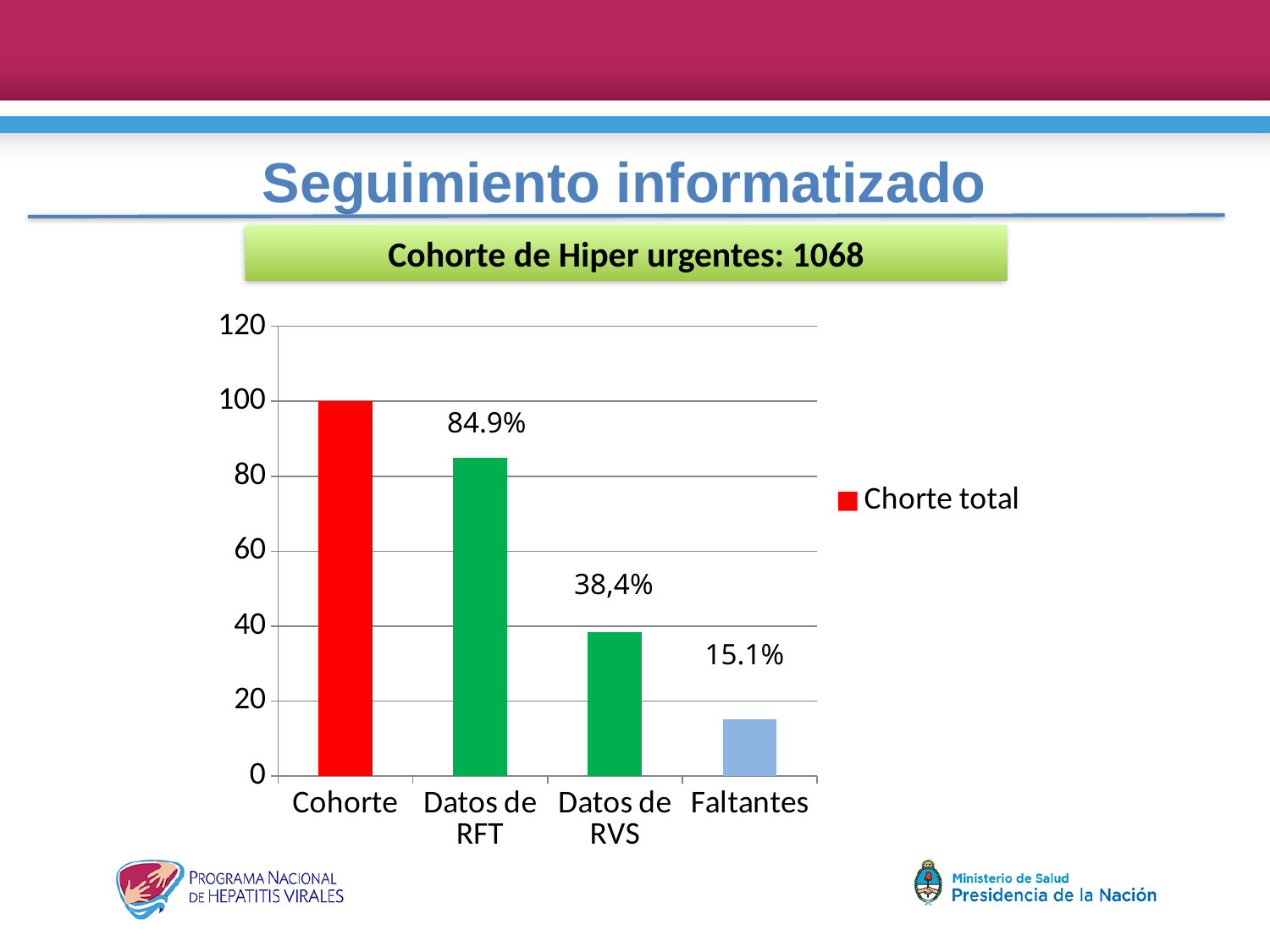
What value is labelled on the bar for Datos de RVS? 38,4% What is the difference between the labelled values for Datos de RFT and Faltantes? 69.8% How many categories are shown on the x axis? 4 Is the value for Datos de RVS greater or less than 40? less Which is larger, the value for Datos de RFT or the value for Datos de RVS? Datos de RFT What value is labelled on the bar for Faltantes? 15.1% What value does the Cohorte bar reach on the vertical axis? 100 What kind of chart is shown on the slide? bar chart Which category has the highest bar? Cohorte Which category has the lowest bar? Faltantes What is the legend entry shown next to the chart? Chorte total What value is labelled on the bar for Datos de RFT? 84.9%